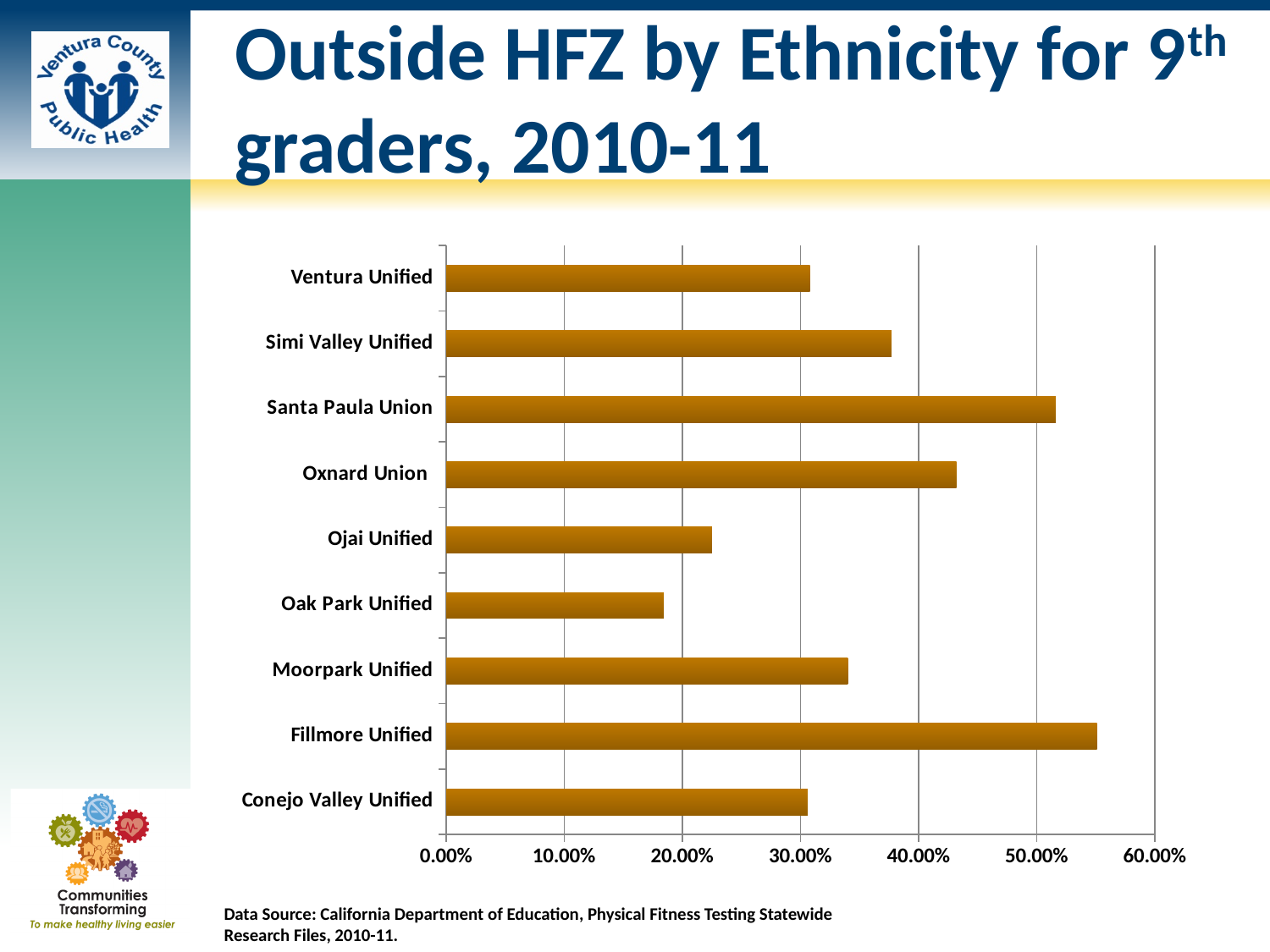
Which district has the lowest percentage outside the HFZ? Oak Park Unified Is the value for Oak Park Unified greater or less than 20.00%? less Is the value for Ojai Unified greater or less than 20.00%? greater Which is larger, the value for Oxnard Union or the value for Simi Valley Unified? Oxnard Union Is the value for Santa Paula Union greater or less than 50.00%? greater Which is larger, the value for Ojai Unified or the value for Oak Park Unified? Ojai Unified Which district has the highest percentage outside the HFZ? Fillmore Unified How many school districts are shown on the chart? 9 What kind of chart is shown on the slide? bar chart What is the highest value shown on the horizontal axis of the chart? 60.00%